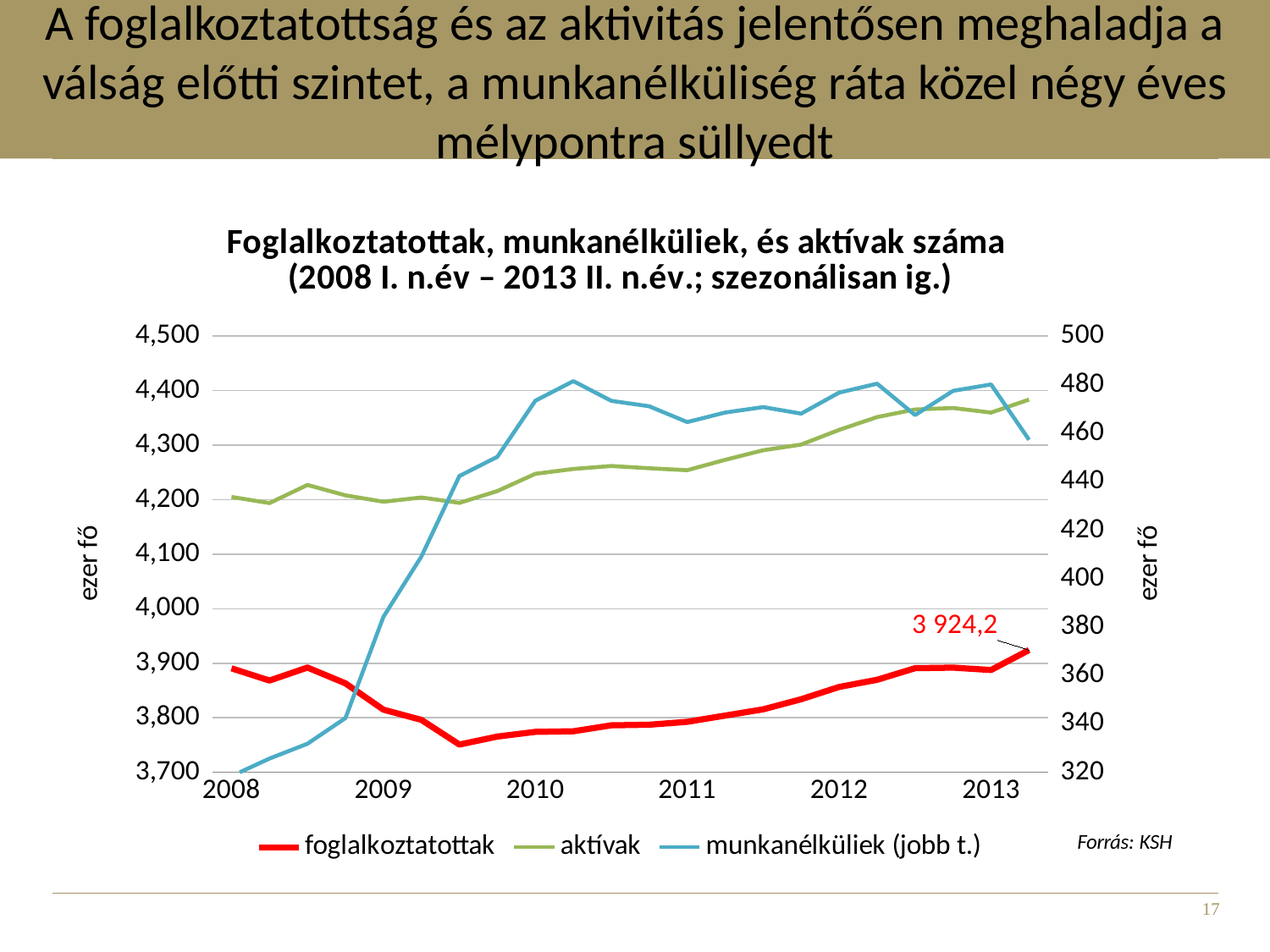
Is the value for foglalkoztatottak at the start of 2008 greater or less than 3,800? greater What type of chart is shown on the slide? line chart What is the title of the chart? Foglalkoztatottak, munkanélküliek, és aktívak száma (2008 I. n.év – 2013 II. n.év.; szezonálisan ig.) How many series does the legend list? 3 Does the munkanélküliek series rise or fall between 2008 and 2010? rise Does the foglalkoztatottak series rise or fall between 2012 and 2013? rise Is the value for munkanélküliek at the start of 2008 greater or less than 340 on the right axis? less Which series is plotted on the right-hand axis? munkanélküliek (jobb t.) What is the labelled final value of the foglalkoztatottak series? 3 924,2 Is the value for aktívak at the end of the series in 2013 greater or less than 4,300? greater At 2010, which is higher on the left axis: aktívak or foglalkoztatottak? aktívak